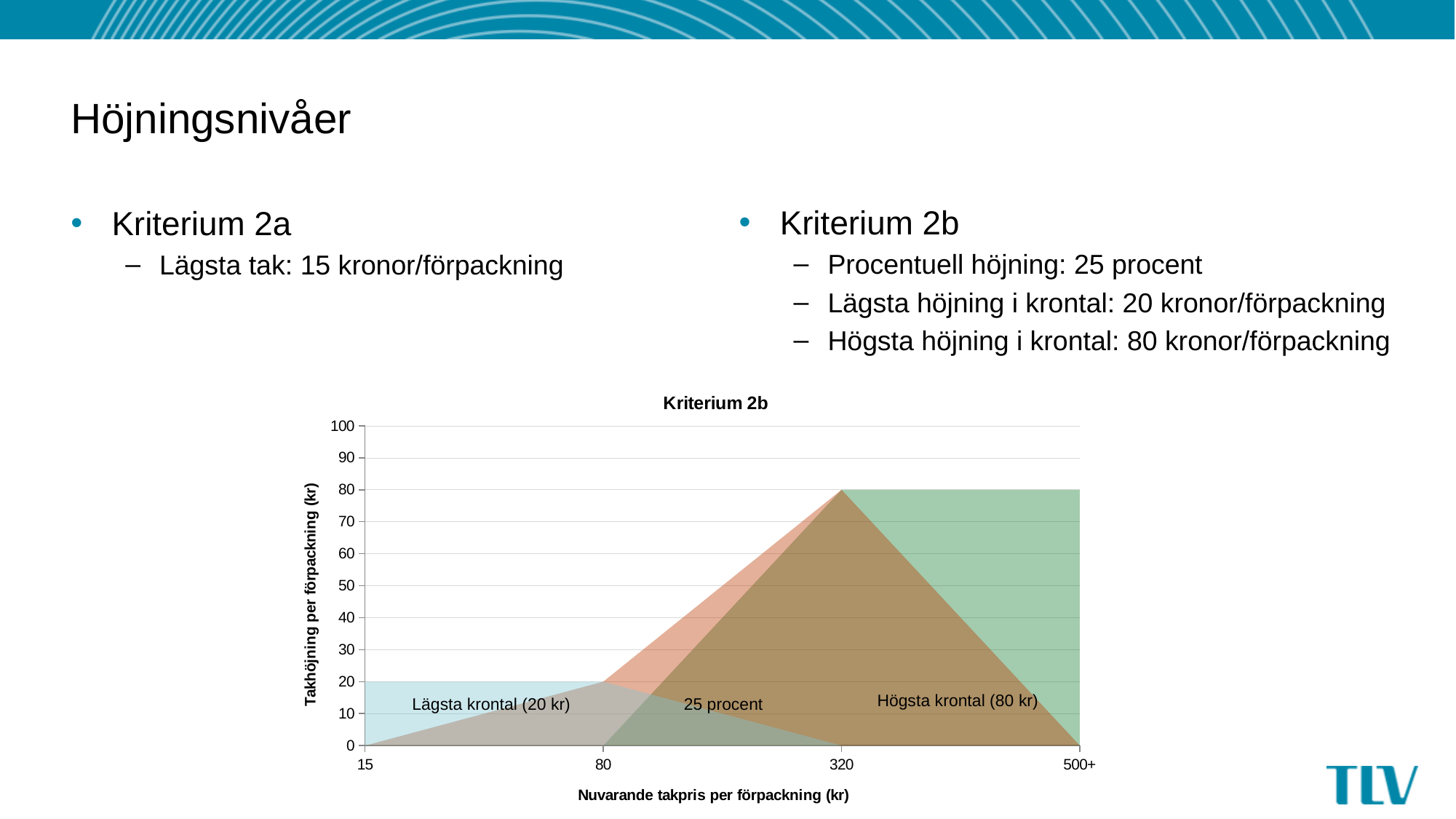
What is the value of the 'Lägsta krontal (20 kr)' series at x = 15? 20 What is the title of the chart? Kriterium 2b Does the '25 procent' series rise or fall between x = 80 and x = 320? rise What is the value of the '25 procent' series at x = 80? 20 What is the value of the 'Högsta krontal (80 kr)' series at x = 500+? 80 What is the label of the x axis of the chart? Nuvarande takpris per förpackning (kr) What kind of chart is shown on the slide? area chart What is the value of the '25 procent' series at x = 320? 80 Which series has the highest value at x = 500+? Högsta krontal (80 kr) How many series are labelled in the chart? 3 What is the difference between the '25 procent' series at x = 320 and at x = 80? 60 How many categories are shown on the x axis of the chart? 4